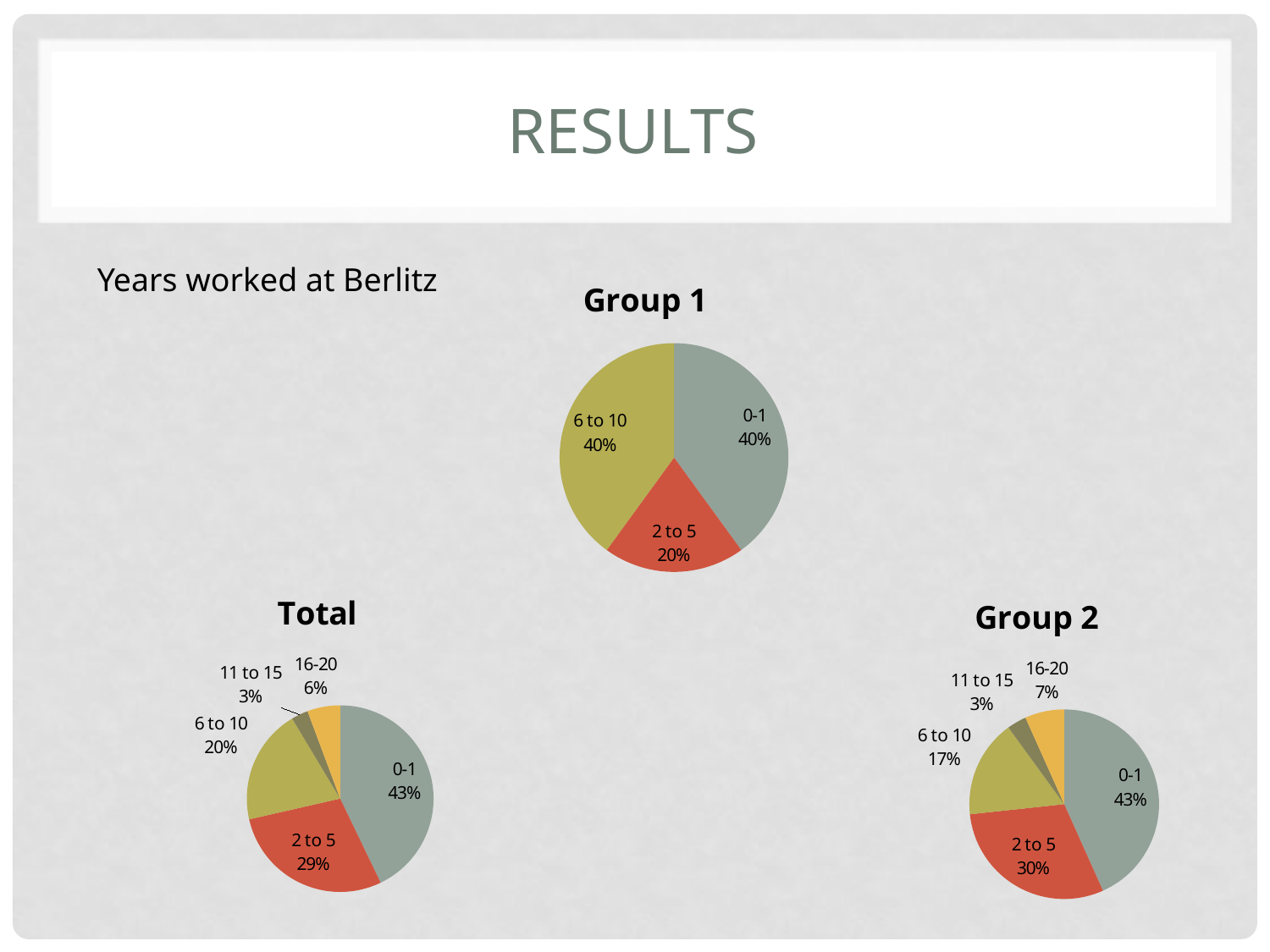
In the Group 2 chart, what share of the pie is the 2 to 5 slice? 30% In the Group 1 chart, which category has the smallest slice? 2 to 5 In the Total chart, which category has the smallest slice? 11 to 15 In the Group 2 chart, which category has the largest slice? 0-1 In the Group 1 chart, what share of the pie is the 6 to 10 slice? 40% In the Total chart, what share of the pie is the 0-1 slice? 43% How many categories does the Total chart show? 5 In the Group 2 chart, what is the difference between the 0-1 share and the 2 to 5 share? 13% What kind of chart is the Group 1 chart? Pie chart